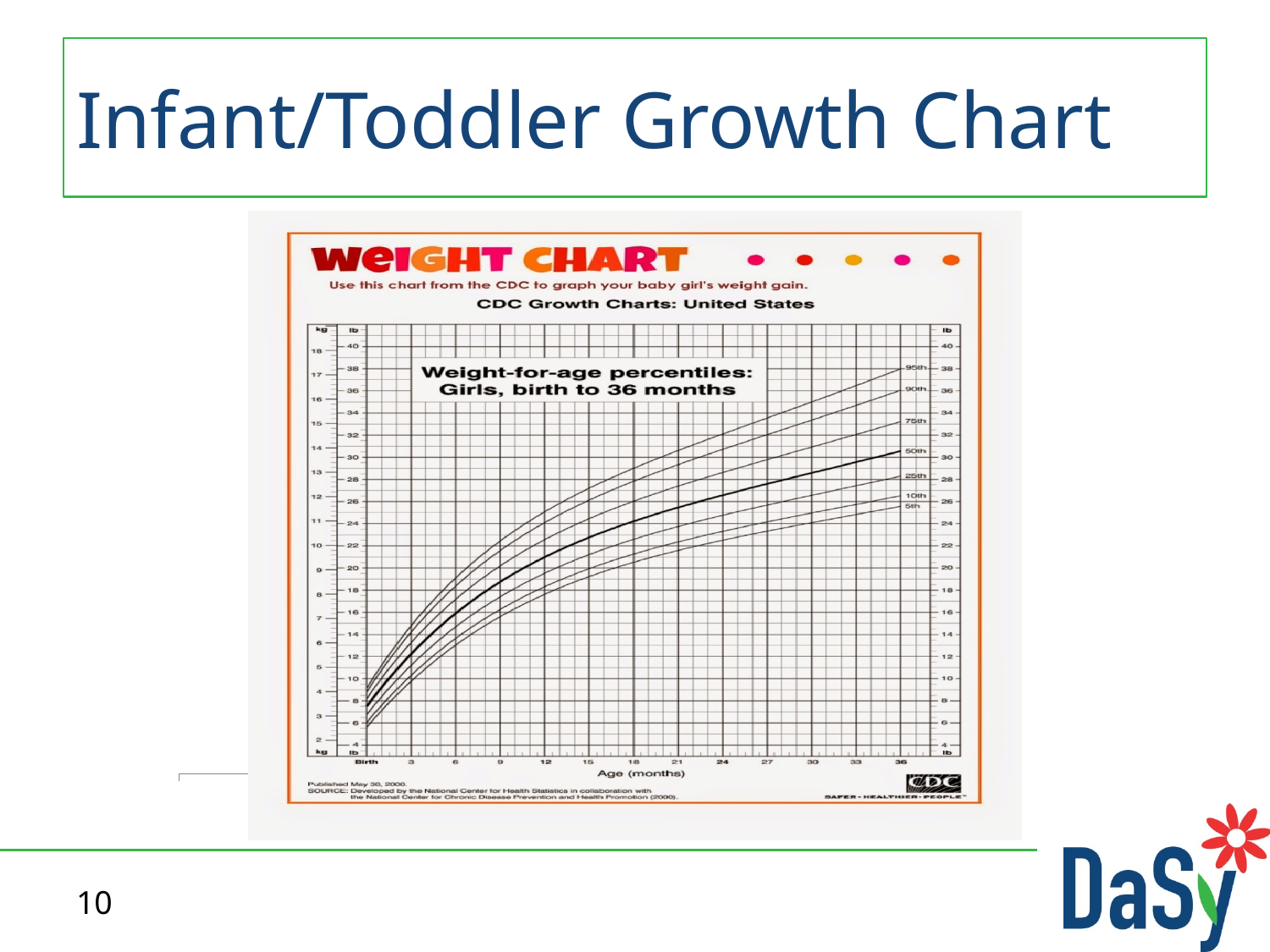
What is the title printed inside the plot area of the chart? Weight-for-age percentiles: Girls, birth to 36 months What is the label of the x axis of the chart? Age (months) How many percentile curves are plotted on the chart? 7 Is the 5th percentile weight at 36 months greater or less than 28 lb? less Is the 95th percentile weight at 36 months greater or less than 34 lb? greater Is the 50th percentile weight at 12 months greater or less than 26 lb? less Which percentile curve is the highest on the chart? 95th What kind of chart is shown on the slide? line chart Which is larger at 36 months, the 75th percentile weight or the 25th percentile weight? 75th percentile Do the percentile curves rise or fall as age in months increases? rise Which percentile curve is the lowest on the chart? 5th